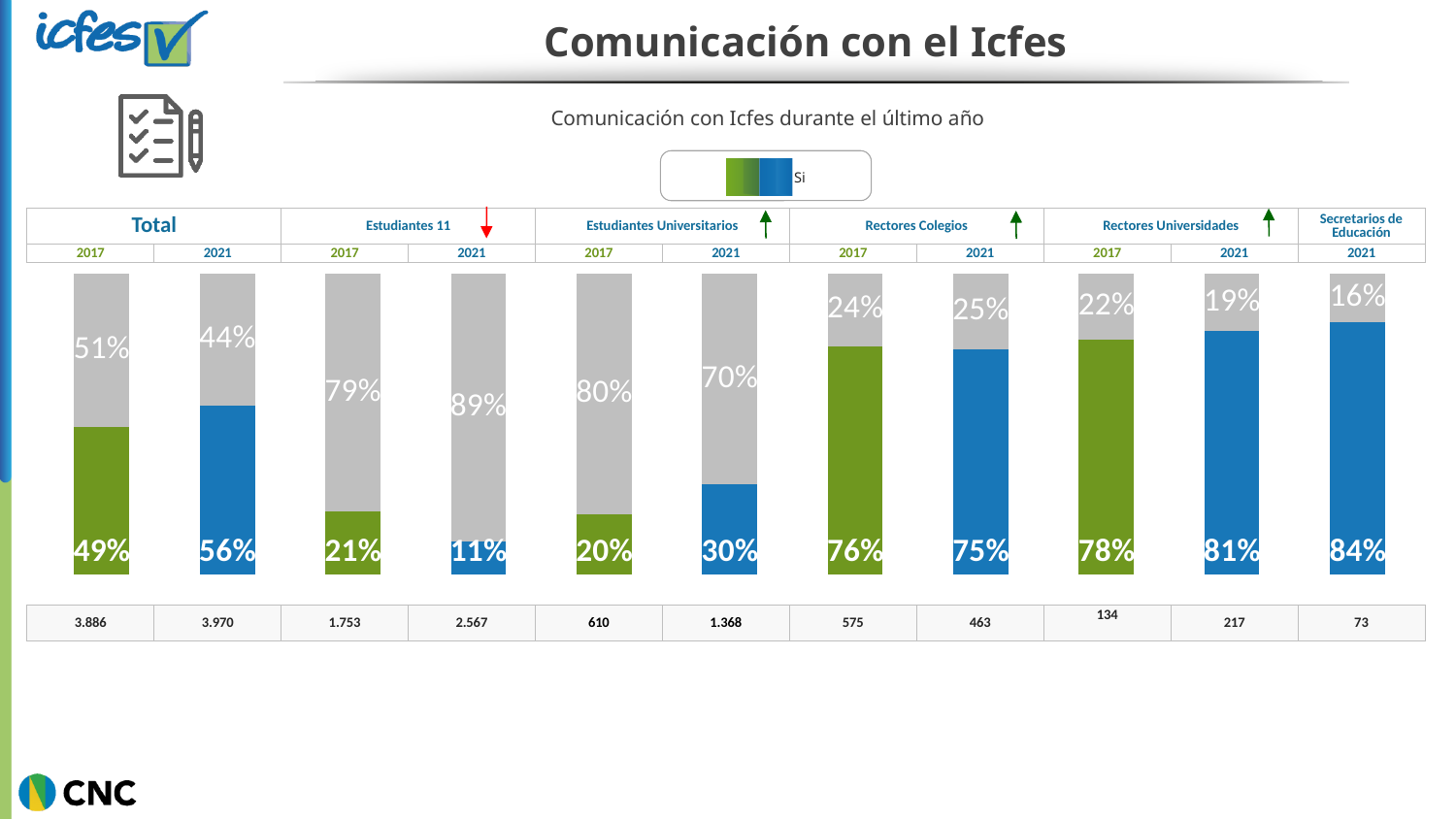
Which bar has the lowest 'Si' percentage? Estudiantes 11 2021 Which bar has the highest 'Si' percentage? Secretarios de Educación 2021 Did the 'Si' percentage for the Total group rise or fall from 2017 to 2021? Rise What kind of chart is shown on the slide? Stacked bar chart What percentage of the Total group in 2021 said 'Si' to communication with Icfes during the last year? 56% Which is larger: the 'Si' percentage for Rectores Colegios in 2017 or for Rectores Universidades in 2017? Rectores Universidades 2017 What is the total of the two segments in the Estudiantes 11 2017 bar? 100% What is the 'Si' percentage for Estudiantes 11 in 2021? 11% By how many percentage points did the 'Si' share for Estudiantes Universitarios change from 2017 to 2021? 10 percentage points How many bars are plotted in the chart? 11 What is the 'Si' percentage for Secretarios de Educación in 2021? 84% What is the gray (non-'Si') percentage shown for Estudiantes Universitarios in 2017? 80%